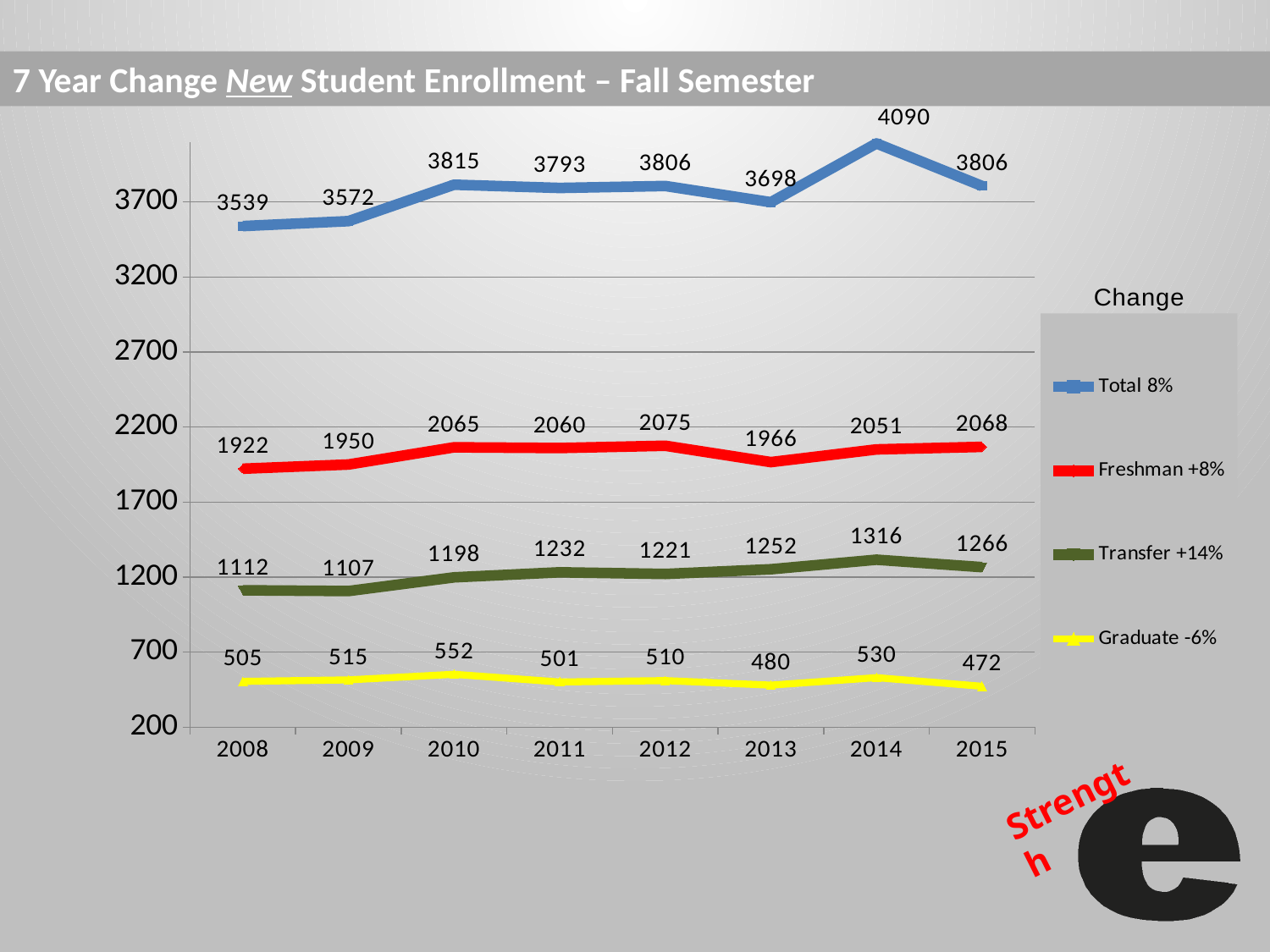
What is the difference between the Total values for 2014 and 2015? 284 What is the Graduate enrollment value for 2015? 472 What is the Transfer enrollment value for 2011? 1232 How many years are shown on the x axis? 8 How many series does the legend list? 4 In which year is the Graduate series lowest? 2015 What is the Freshman enrollment value for 2008? 1922 Which is larger, the Transfer value for 2014 or the Transfer value for 2015? 2014 What percentage change does the legend show for the Transfer series? +14% What is the Total new student enrollment value for 2014? 4090 What kind of chart is shown on the slide? line chart In which year is the Total series highest? 2014